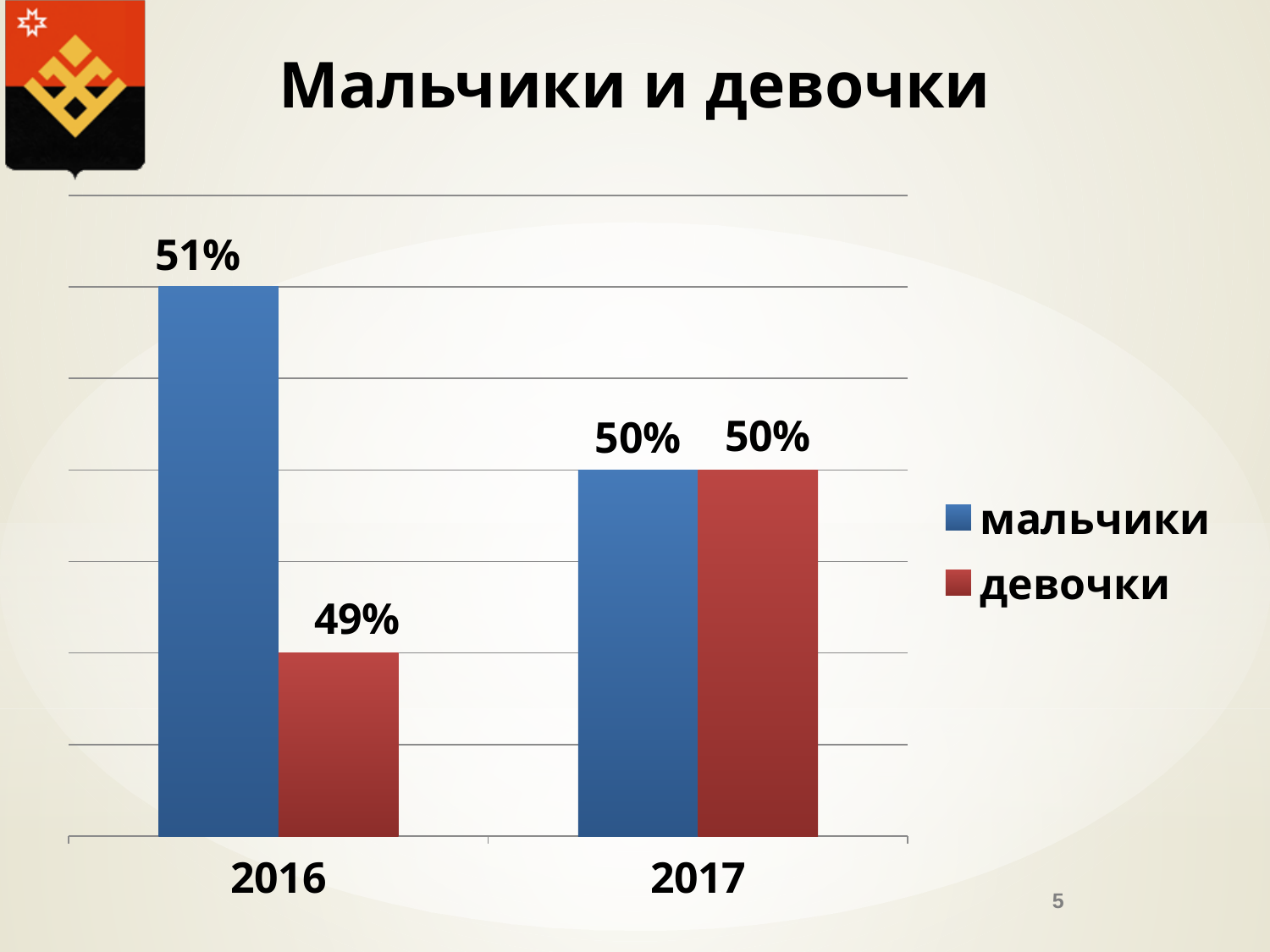
What is the difference between the мальчики and девочки values in 2016? 2% What kind of chart is shown on the slide? bar chart Which bar shows the highest value on the chart? мальчики in 2016 Which bar shows the lowest value on the chart? девочки in 2016 How many series does the legend list? 2 What is the value for девочки in 2016? 49% Does the value for мальчики rise or fall from 2016 to 2017? fall What is the value for девочки in 2017? 50% How many years are shown on the x axis? 2 What is the value for мальчики in 2017? 50% Which series has the higher value in 2016, мальчики or девочки? мальчики What is the value for мальчики in 2016? 51%